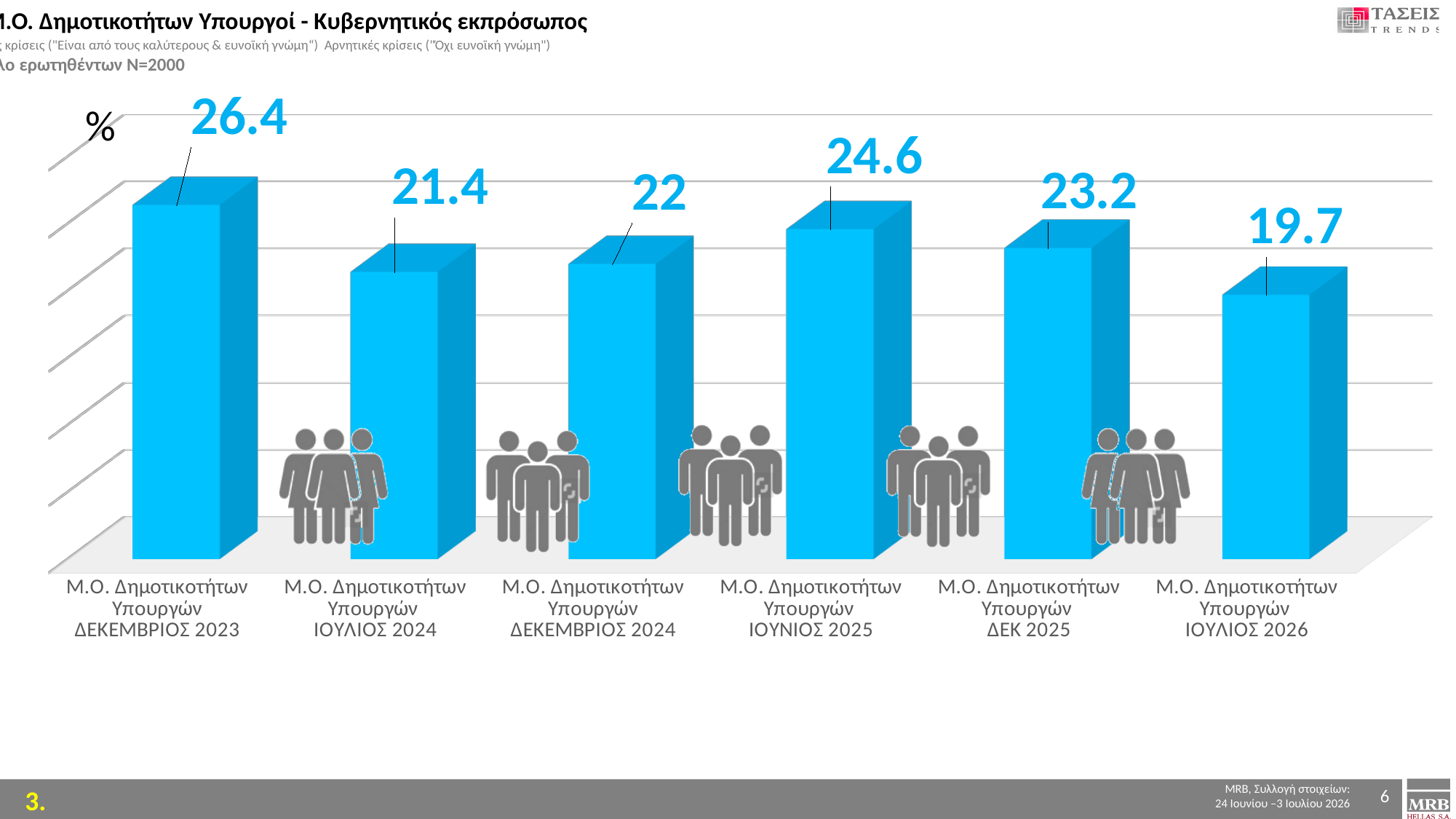
What is the difference between the values for ΔΕΚΕΜΒΡΙΟΣ 2023 and ΙΟΥΛΙΟΣ 2026? 6.7 What kind of chart is shown on the slide? bar chart What is the value for ΙΟΥΝΙΟΣ 2025? 24.6 Does the value rise or fall from ΔΕΚ 2025 to ΙΟΥΛΙΟΣ 2026? fall What is the value for ΙΟΥΛΙΟΣ 2024? 21.4 What is the value for ΙΟΥΛΙΟΣ 2026? 19.7 What is the difference between the values for ΙΟΥΝΙΟΣ 2025 and ΔΕΚ 2025? 1.4 How many bars are shown in the chart? 6 What is the value for ΔΕΚΕΜΒΡΙΟΣ 2023? 26.4 Which is larger, the value for ΔΕΚΕΜΒΡΙΟΣ 2024 or the value for ΔΕΚ 2025? ΔΕΚ 2025 Which period has the highest value? ΔΕΚΕΜΒΡΙΟΣ 2023 Which period has the lowest value? ΙΟΥΛΙΟΣ 2026